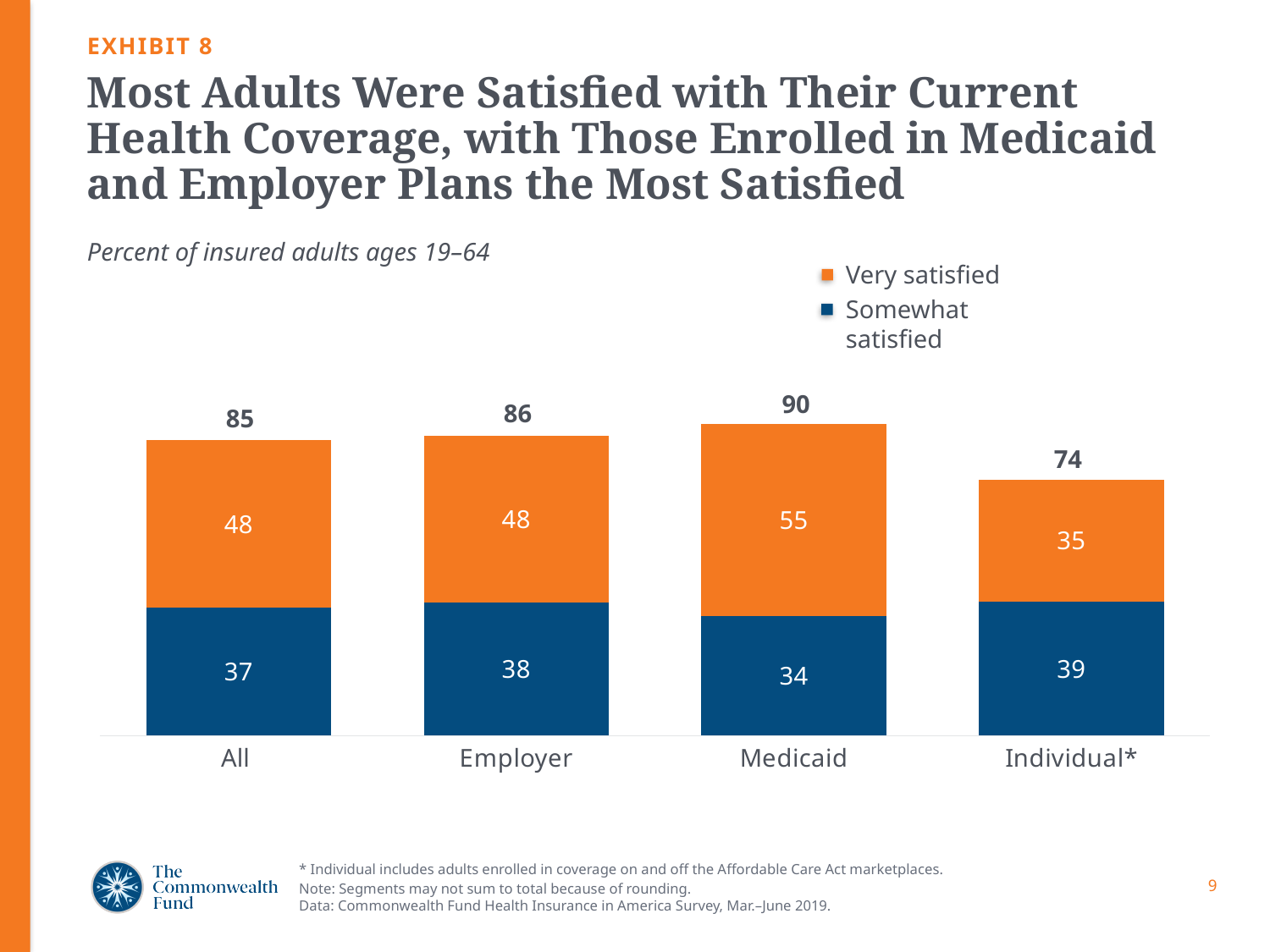
Which is larger: the 'Somewhat satisfied' value for Employer or for Medicaid? Employer What is the 'Very satisfied' value for All? 48 What is the difference between the 'Very satisfied' values for Medicaid and Individual*? 20 What is the 'Somewhat satisfied' value for Individual*? 39 Which category has the highest total satisfied percentage? Medicaid What is the total printed above the Employer bar? 86 What is the 'Very satisfied' value for Medicaid? 55 How many categories are shown on the x axis? 4 Which category has the lowest total satisfied percentage? Individual* Which colour represents 'Very satisfied' in the legend? Orange What kind of chart is shown on the slide? Stacked bar chart How many series does the legend list? 2